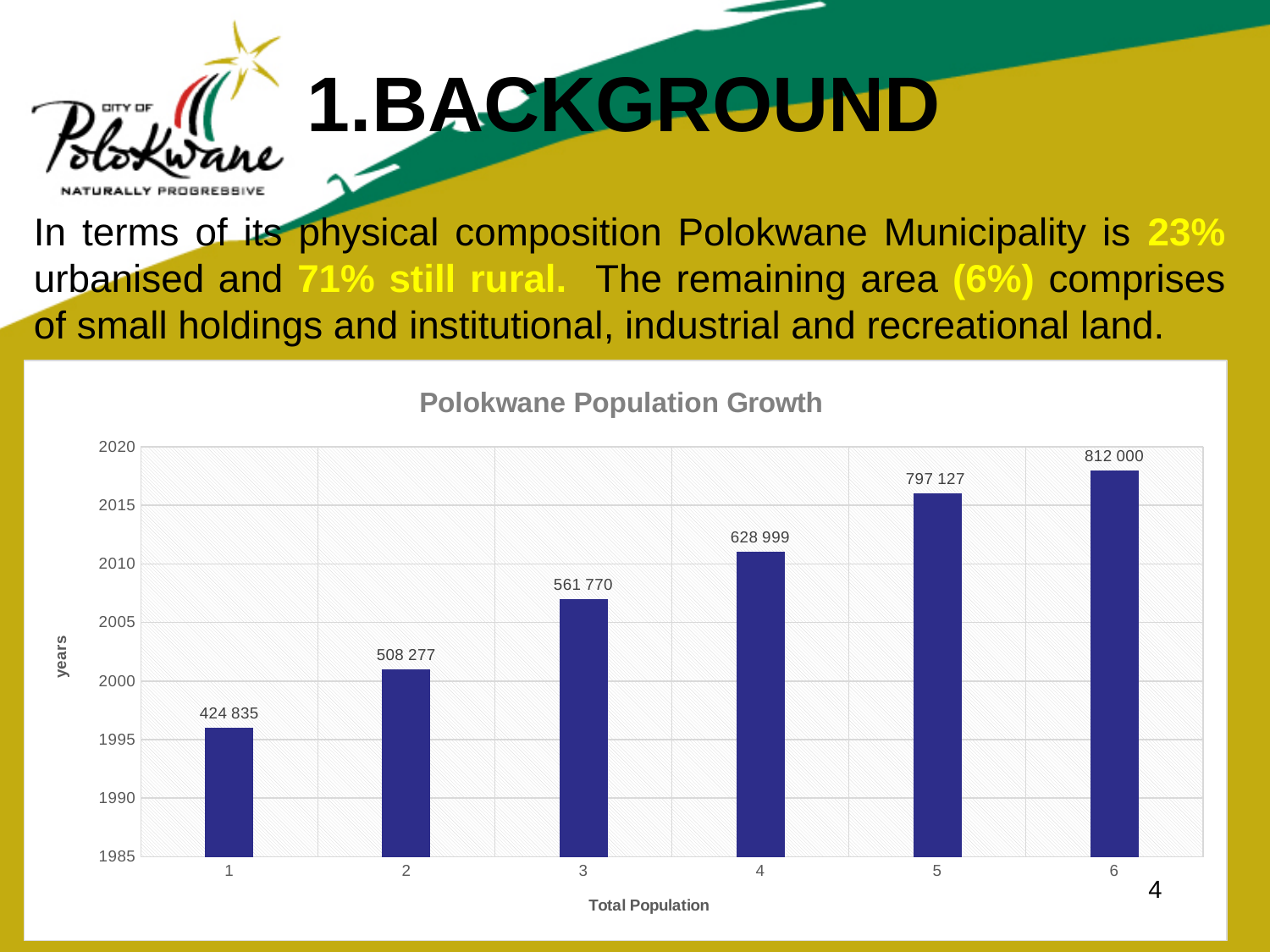
What data label is shown on the bar for category 5? 797 127 What type of chart is shown under the title 'Polokwane Population Growth'? bar chart Which bar is taller, category 2 or category 4? category 4 What data label is shown on the bar for category 3? 561 770 How many bars are plotted in the Polokwane Population Growth chart? 6 Which category has the tallest bar in the chart? 6 What is the difference between the data labels for category 6 and category 5? 14 873 What data label is shown on the bar for category 1? 424 835 Do the bar heights rise or fall from category 1 to category 6? rise What is the label on the vertical axis of the chart? years What is the title of the chart on the slide? Polokwane Population Growth Which category has the shortest bar in the chart? 1